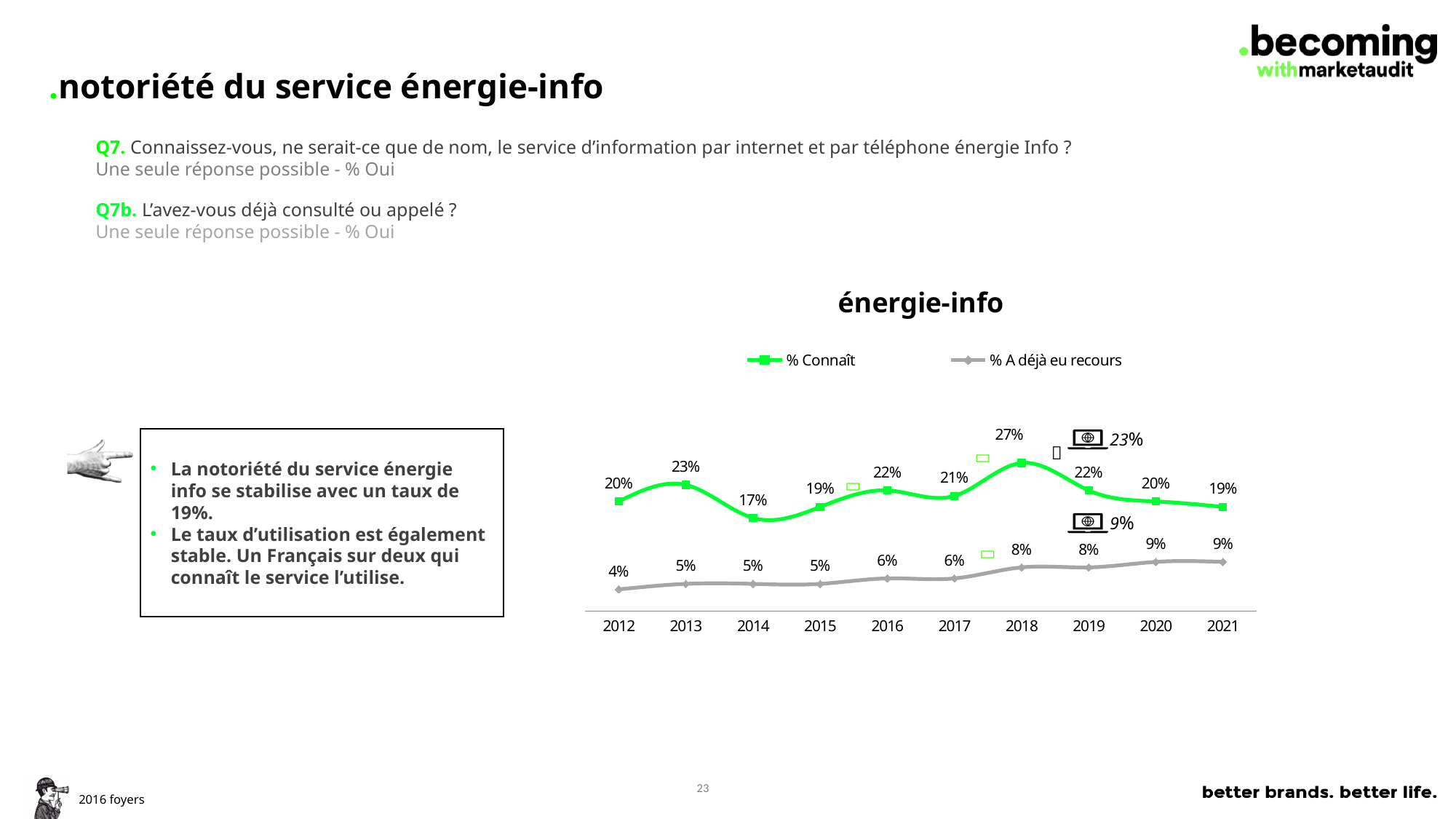
What type of chart is shown on the slide? Line chart Which is larger, % Connaît in 2013 or % Connaît in 2014? % Connaît in 2013 Does % A déjà eu recours rise or fall overall from 2012 to 2021? Rise In which year is % Connaît at its highest? 2018 How many series does the chart legend list? 2 How many years are shown on the x axis of the chart? 10 In which year is % Connaît at its lowest? 2014 What is the value of % A déjà eu recours in 2012? 4% What is the title of the chart? énergie-info What is the difference between % Connaît and % A déjà eu recours in 2021? 10% What is the value of % Connaît in 2018? 27% What is the value of % Connaît in 2021? 19%